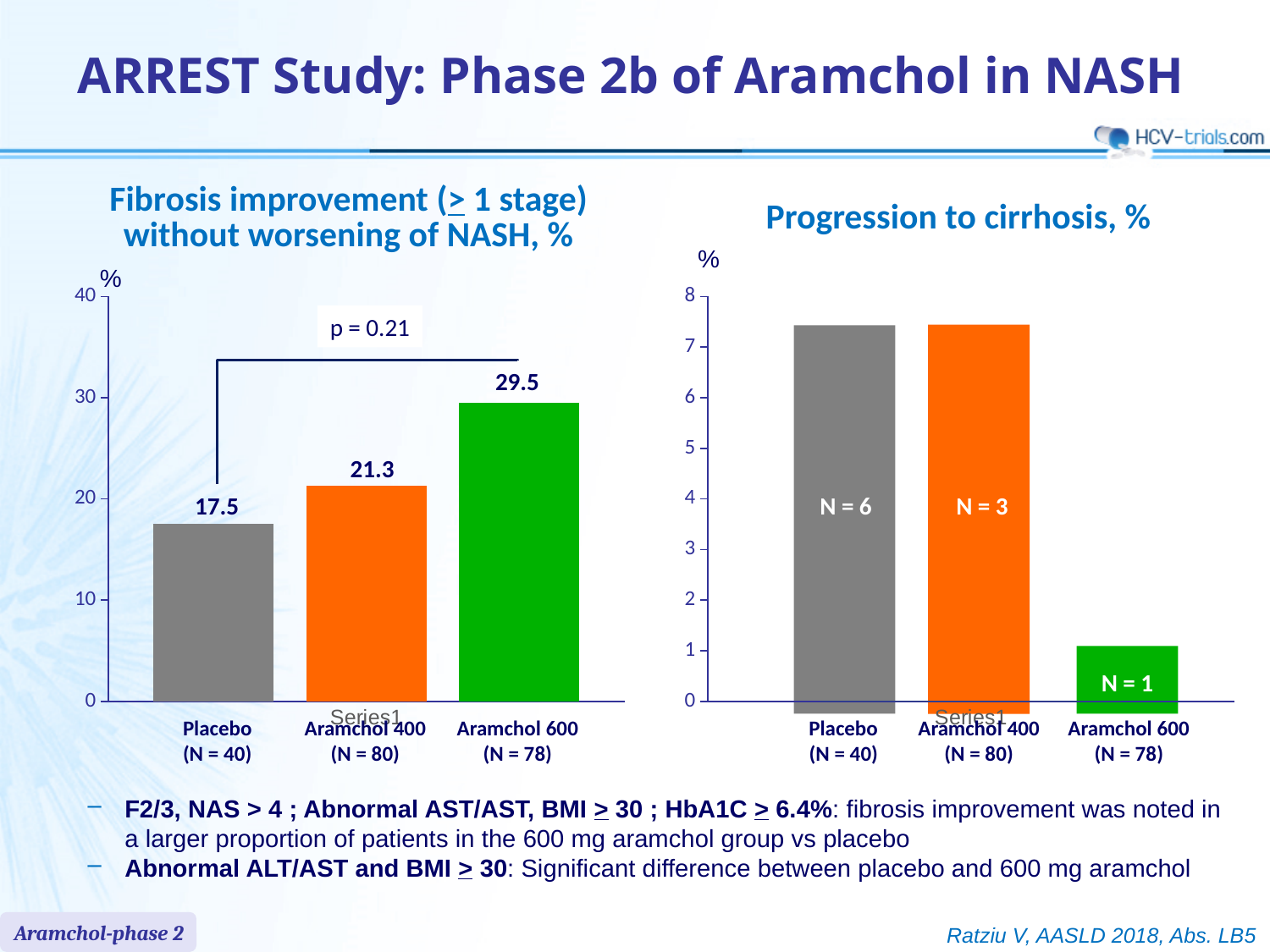
In the 'Fibrosis improvement' chart, what is the value for Placebo (N = 40)? 17.5 In the 'Progression to cirrhosis' chart, is the value for Placebo greater or less than 7? greater In the 'Fibrosis improvement' chart, which group has the lowest value? Placebo What kind of chart is the 'Progression to cirrhosis' chart? bar chart In the 'Fibrosis improvement' chart, what is the value for Aramchol 600 (N = 78)? 29.5 In the 'Progression to cirrhosis' chart, which group has the lowest value? Aramchol 600 In the 'Progression to cirrhosis' chart, what N is printed on the Aramchol 400 bar? N = 3 In the 'Progression to cirrhosis' chart, is the value for Aramchol 600 greater or less than 2? less In the 'Fibrosis improvement' chart, what is the value for Aramchol 400 (N = 80)? 21.3 In the 'Fibrosis improvement' chart, do the values rise or fall from Placebo to Aramchol 600 along the x axis? rise In the 'Fibrosis improvement' chart, which group has the highest value? Aramchol 600 In the 'Fibrosis improvement' chart, what is the difference between Aramchol 600 and Placebo? 12.0